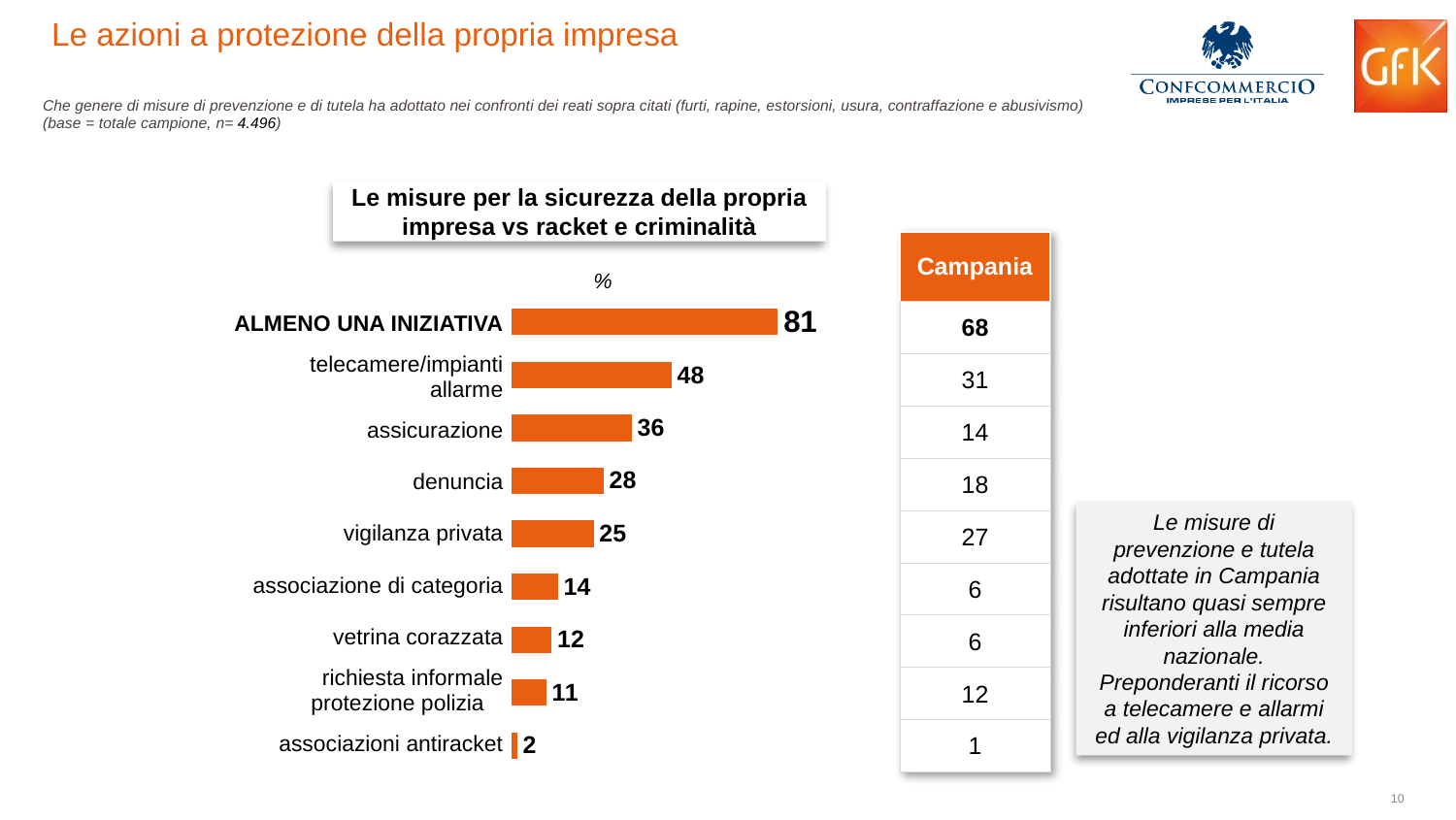
What is the difference between the values for 'ALMENO UNA INIZIATIVA' and 'telecamere/impianti allarme'? 33 Which category has the highest value in the chart? ALMENO UNA INIZIATIVA What is the difference between the values for 'assicurazione' and 'vigilanza privata'? 11 What is the title of the chart? Le misure per la sicurezza della propria impresa vs racket e criminalità What is the value for 'vetrina corazzata' in the chart? 12 Which category has the lowest value in the chart? associazioni antiracket Which is larger, the value for 'associazione di categoria' or the value for 'richiesta informale protezione polizia'? associazione di categoria What unit is indicated above the bars in the chart? % What kind of chart is shown on the slide? bar chart How many categories are shown in the bar chart? 9 What is the value for 'denuncia' in the chart? 28 What is the value for 'telecamere/impianti allarme' in the chart? 48